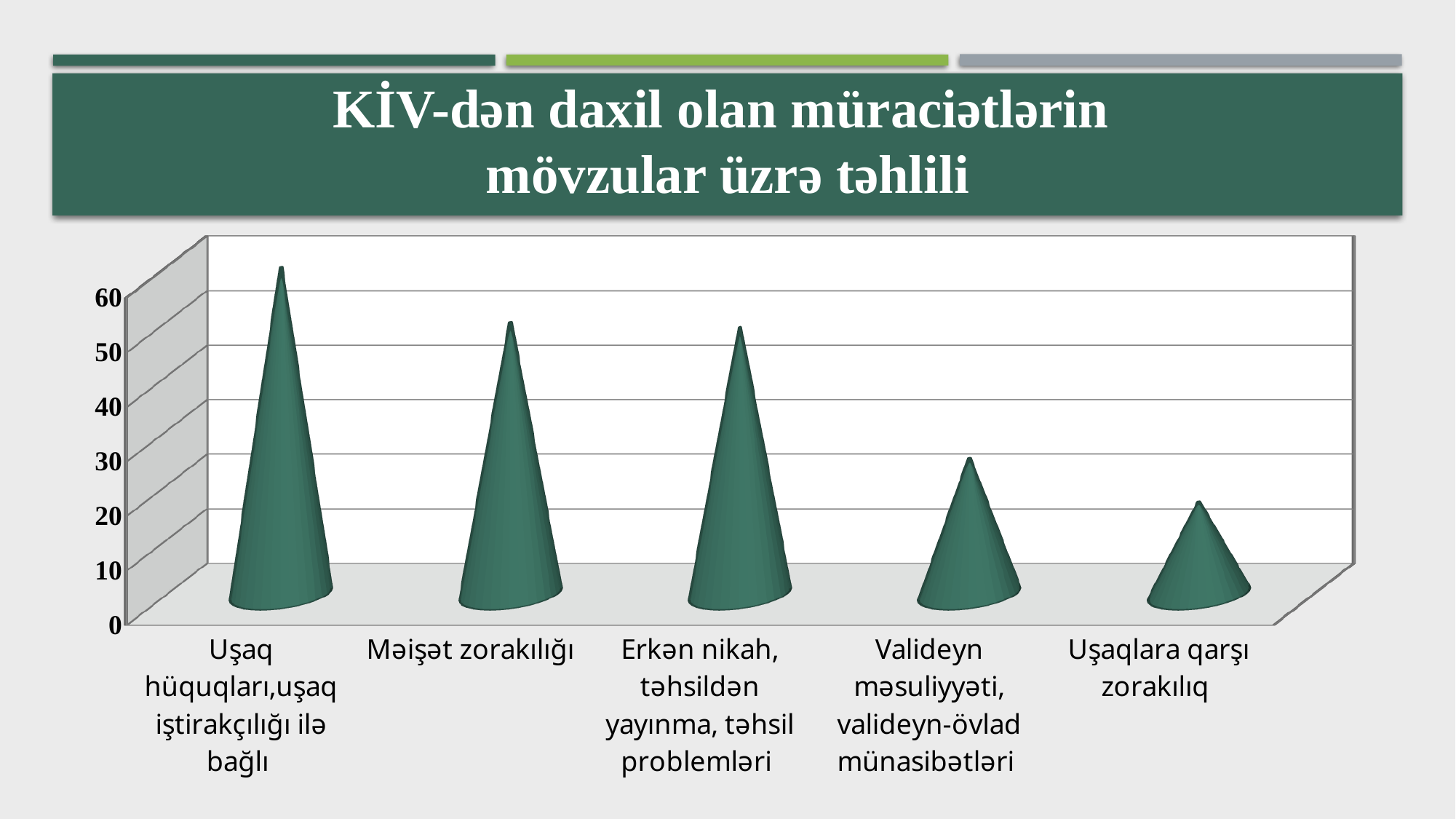
Which category has the highest value in the chart? Uşaq hüquqları,uşaq iştirakçılığı ilə bağlı Is the value for 'Uşaqlara qarşı zorakılıq' greater or less than 30? less Which is larger: the value for 'Məişət zorakılığı' or the value for 'Uşaqlara qarşı zorakılıq'? Məişət zorakılığı Which category has the lowest value in the chart? Uşaqlara qarşı zorakılıq How many categories are shown on the x axis of the chart? 5 What is the title of the slide containing the chart? KİV-dən daxil olan müraciətlərin mövzular üzrə təhlili Do the values generally rise or fall from left to right along the x axis? fall Is the value for 'Valideyn məsuliyyəti, valideyn-övlad münasibətləri' greater or less than 40? less Which is larger: the value for 'Valideyn məsuliyyəti, valideyn-övlad münasibətləri' or the value for 'Erkən nikah, təhsildən yayınma, təhsil problemləri'? Erkən nikah, təhsildən yayınma, təhsil problemləri What kind of chart is shown on the slide? bar chart